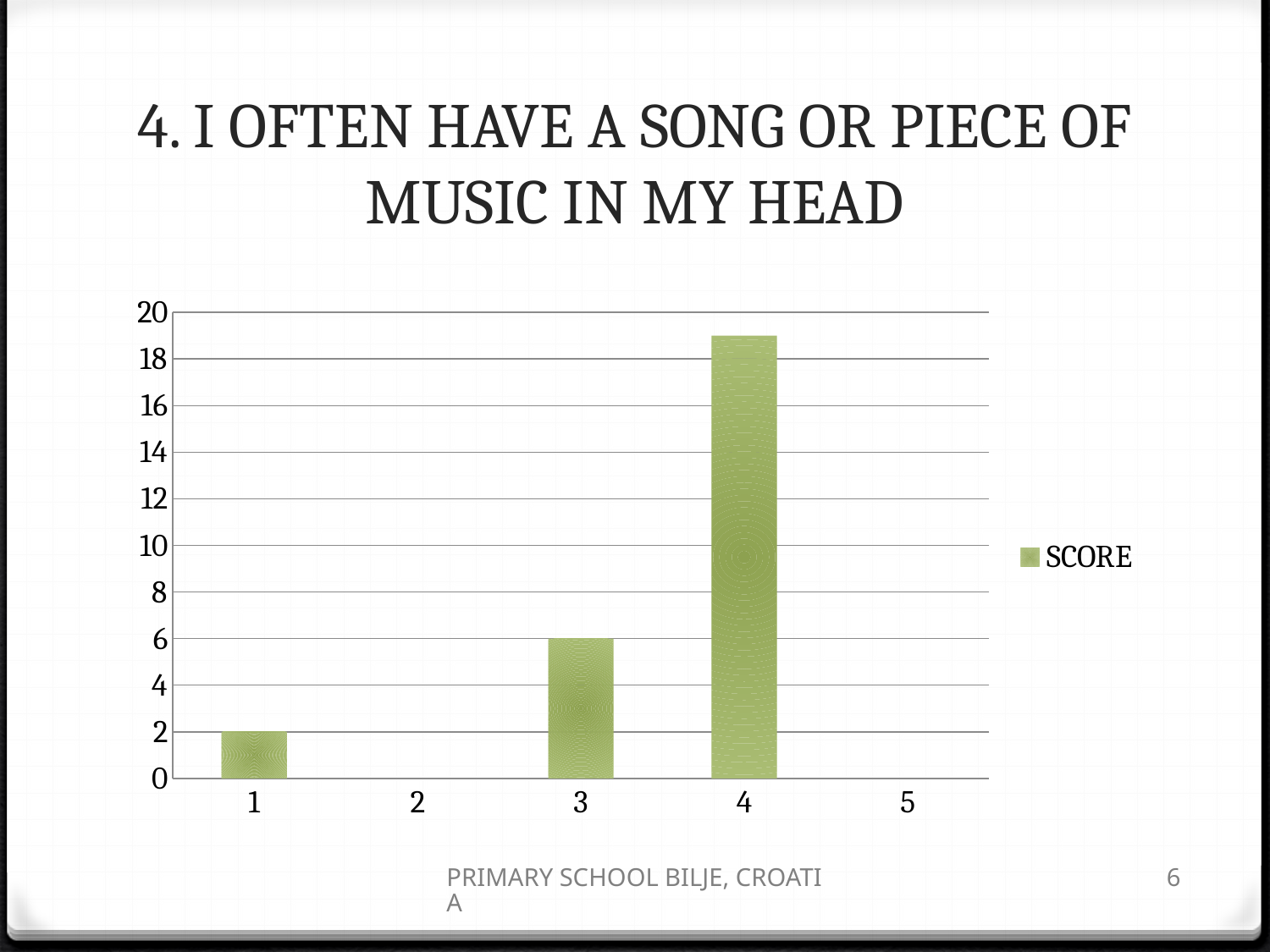
Among the categories with a visible bar, which has the lowest SCORE? 1 Which has a larger SCORE, category 3 or category 1? 3 Is the SCORE for category 4 greater or less than 18? greater Which category has the highest SCORE? 4 How many categories are shown on the x axis? 5 How many series does the legend list? 1 What is the name of the series shown in the legend? SCORE Is the SCORE for category 3 greater or less than 10? less What is the SCORE value for category 3? 6 What is the SCORE value for category 1? 2 What type of chart is shown on the slide? bar chart What is the difference between the SCORE for category 3 and the SCORE for category 1? 4